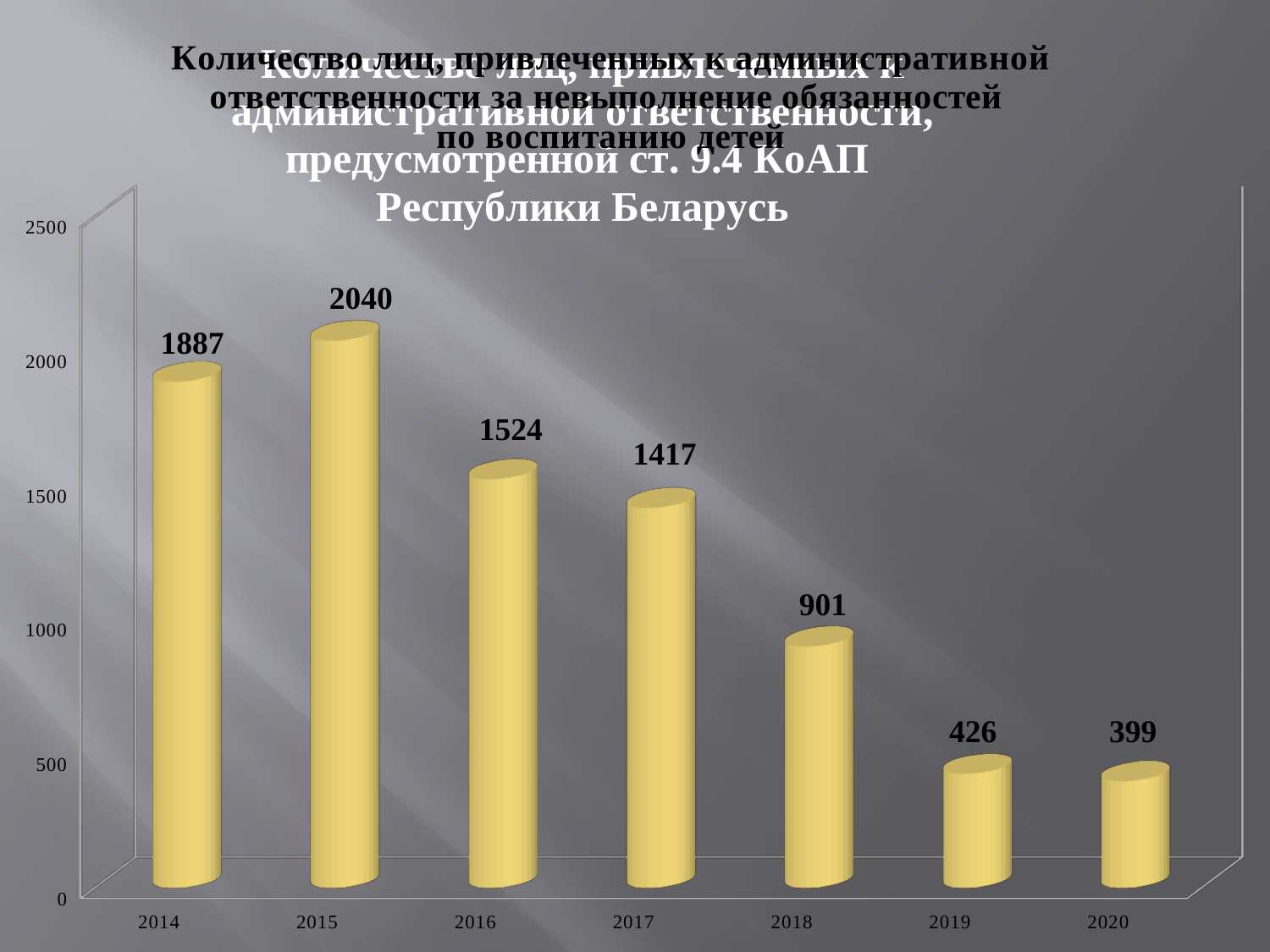
Which is larger, the value for 2016 or the value for 2017? 2016 What is the difference between the values for 2017 and 2018? 516 Which year has the highest value? 2015 What is the difference between the values for 2015 and 2014? 153 Do the values generally rise or fall from 2015 to 2020? fall What kind of chart is shown on the slide? bar chart What is the value for 2018? 901 What is the value for 2020? 399 What is the value for 2014? 1887 Which year has the lowest value? 2020 Is the value for 2019 greater or less than 500? less How many years are shown on the x axis? 7